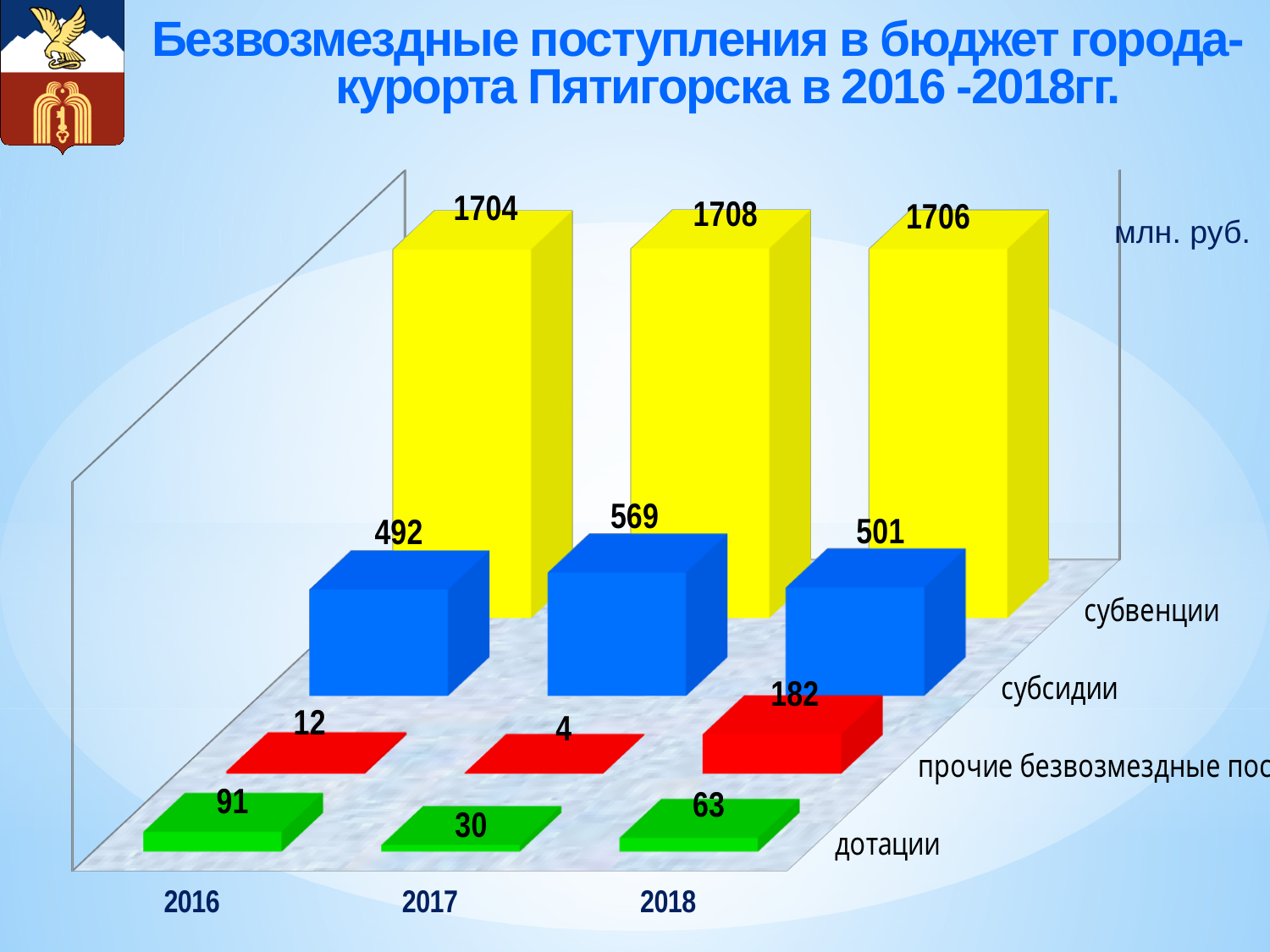
What is the value for субвенции in 2017? 1708 Which is larger, the субвенции value for 2018 or for 2016? 2018 What is the value for the red series (прочие безвозмездные...) in 2017? 4 How many years are shown on the x axis? 3 What is the value for субсидии in 2016? 492 What kind of chart is shown on the slide? bar chart In which year is the value for дотации the lowest? 2017 How many data series does the chart show? 4 What is the value for дотации in 2018? 63 What is the difference between the red series (прочие безвозмездные...) values for 2018 and 2017? 178 What is the difference between the субсидии values for 2017 and 2016? 77 In which year is the value for субсидии the highest? 2017